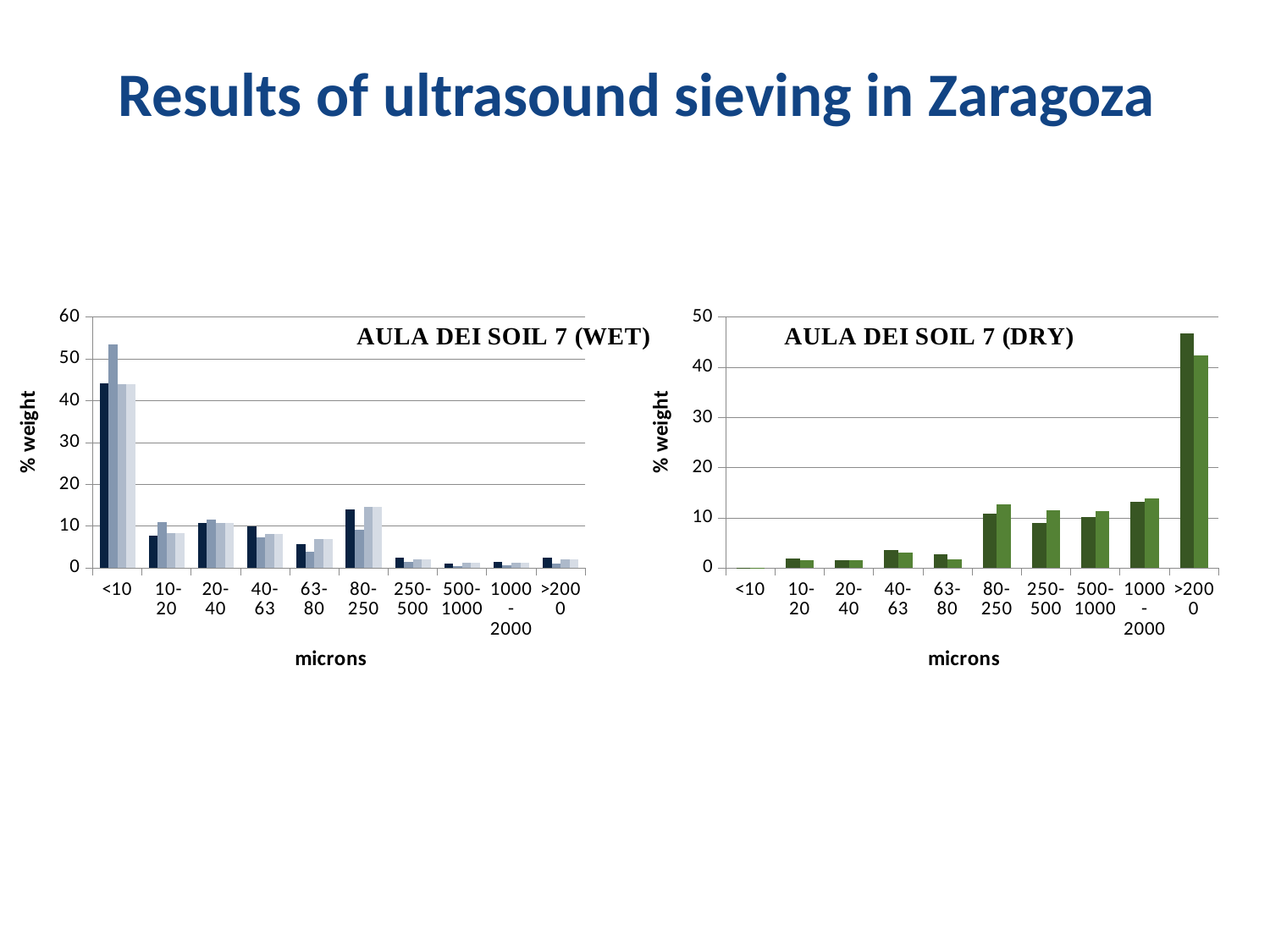
In the AULA DEI SOIL 7 (WET) chart, which size category has the highest % weight? <10 In the AULA DEI SOIL 7 (DRY) chart, is the tallest bar for the >2000 category greater or less than 40? greater In the AULA DEI SOIL 7 (WET) chart, which category has a larger % weight, <10 or 80-250? <10 In the AULA DEI SOIL 7 (DRY) chart, which size category has the highest % weight? >2000 In the AULA DEI SOIL 7 (DRY) chart, do the % weight values generally rise or fall from <10 to >2000 along the x axis? rise What is the y-axis label on the AULA DEI SOIL 7 (WET) chart? % weight What kind of chart is the AULA DEI SOIL 7 (WET) chart? bar chart How many size categories are shown on the x axis of the AULA DEI SOIL 7 (DRY) chart? 10 In the AULA DEI SOIL 7 (WET) chart, are the bars for the 80-250 category greater or less than 20? less In the AULA DEI SOIL 7 (DRY) chart, which size category has the lowest % weight? <10 In the AULA DEI SOIL 7 (DRY) chart, are the bars for the 250-500 category greater or less than 20? less